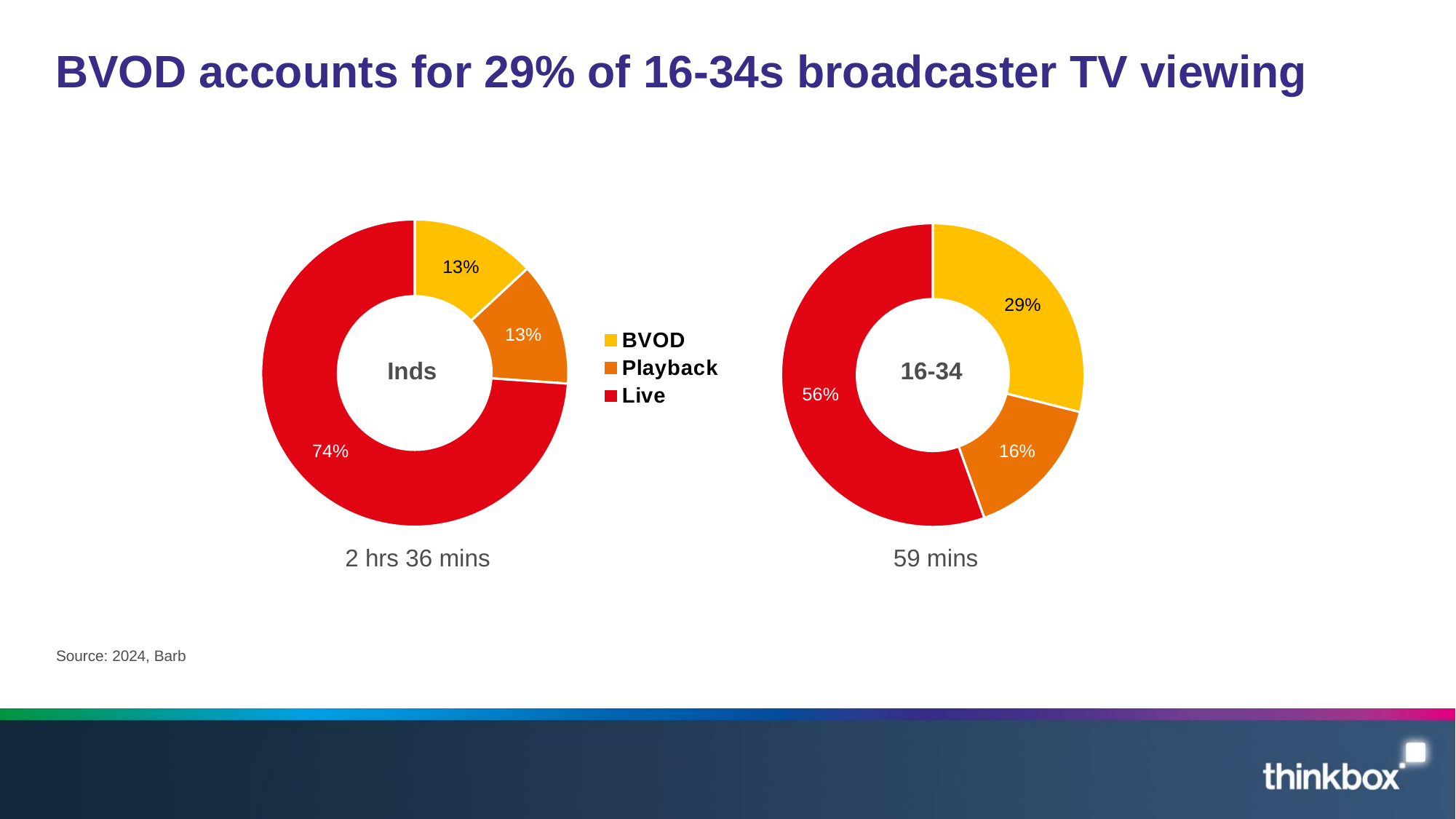
In the Inds donut chart, what share of viewing is BVOD? 13% What is the difference between the Live share in the Inds chart and the Live share in the 16-34 chart? 18 percentage points In the 16-34 donut chart, which category has the largest share? Live Is the BVOD share larger in the Inds chart or the 16-34 chart? 16-34 In the 16-34 donut chart, what share of viewing is BVOD? 29% In the 16-34 donut chart, which category has the smallest share? Playback In the 16-34 donut chart, what share of viewing is Playback? 16% How many series does the legend list? 3 In the Inds donut chart, what share of viewing is Live? 74% Which colour represents Playback in the legend? Orange What kind of chart is used on this slide? Donut (pie) chart What total viewing time is shown beneath the Inds donut chart? 2 hrs 36 mins